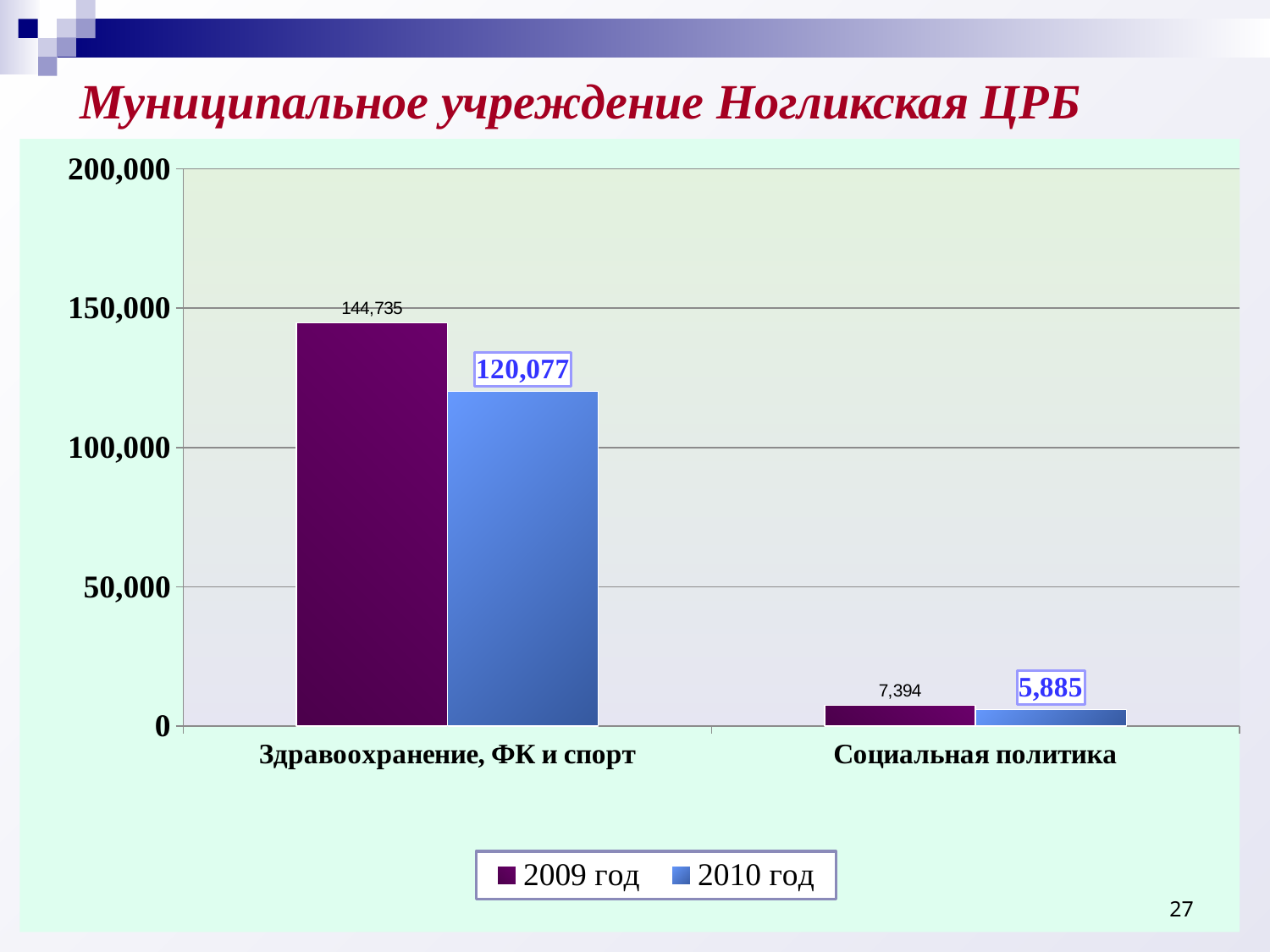
What is the difference between the 2009 год and 2010 год values for Социальная политика? 1,509 Which category has the lowest value in the 2010 год series? Социальная политика What is the value for Здравоохранение, ФК и спорт in the 2009 год series? 144,735 For Социальная политика, which series has the larger value, 2009 год or 2010 год? 2009 год Is the 2010 год value for Здравоохранение, ФК и спорт greater or less than 100,000? greater What is the value for Здравоохранение, ФК и спорт in the 2010 год series? 120,077 What is the value for Социальная политика in the 2009 год series? 7,394 How many series does the legend list? 2 What is the value for Социальная политика in the 2010 год series? 5,885 Which category has the highest value in the 2009 год series? Здравоохранение, ФК и спорт What kind of chart is shown on the slide? Bar chart What is the difference between the 2009 год and 2010 год values for Здравоохранение, ФК и спорт? 24,658